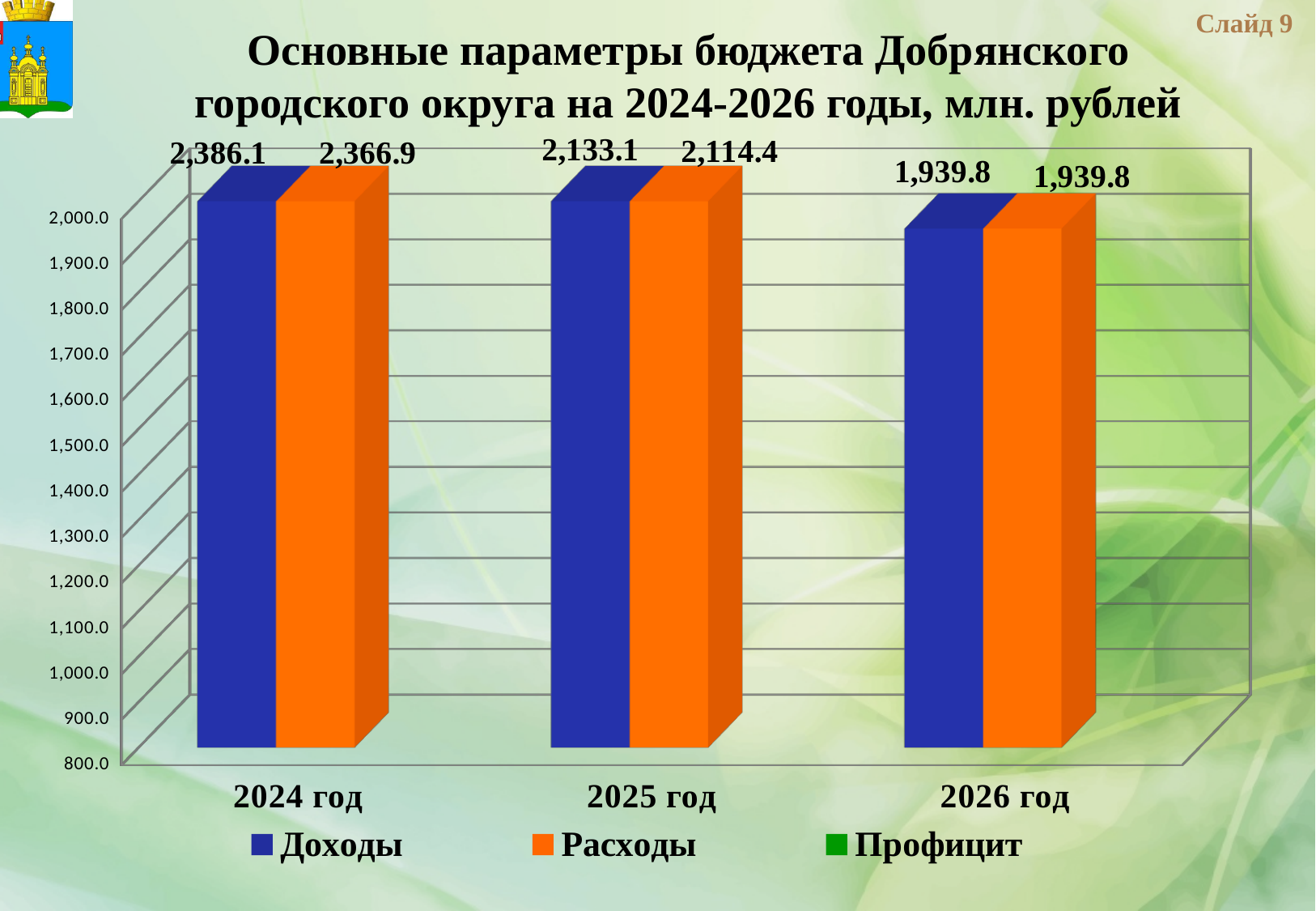
What is the value of Расходы for 2025 год? 2,114.4 Do the Доходы values rise or fall from 2024 год to 2026 год? fall What is the difference between Доходы in 2024 год and Доходы in 2025 год? 253.0 What is the difference between Доходы and Расходы in 2024 год? 19.2 How many years are shown on the x axis? 3 Is the value of Доходы for 2026 год greater or less than 2,000.0? less Which year has the lowest value of Расходы? 2026 год What is the value of Доходы for 2024 год? 2,386.1 Which year has the highest value of Доходы? 2024 год Which is larger in 2025 год: Доходы or Расходы? Доходы How many series does the legend list? 3 What is the value of Расходы for 2026 год? 1,939.8